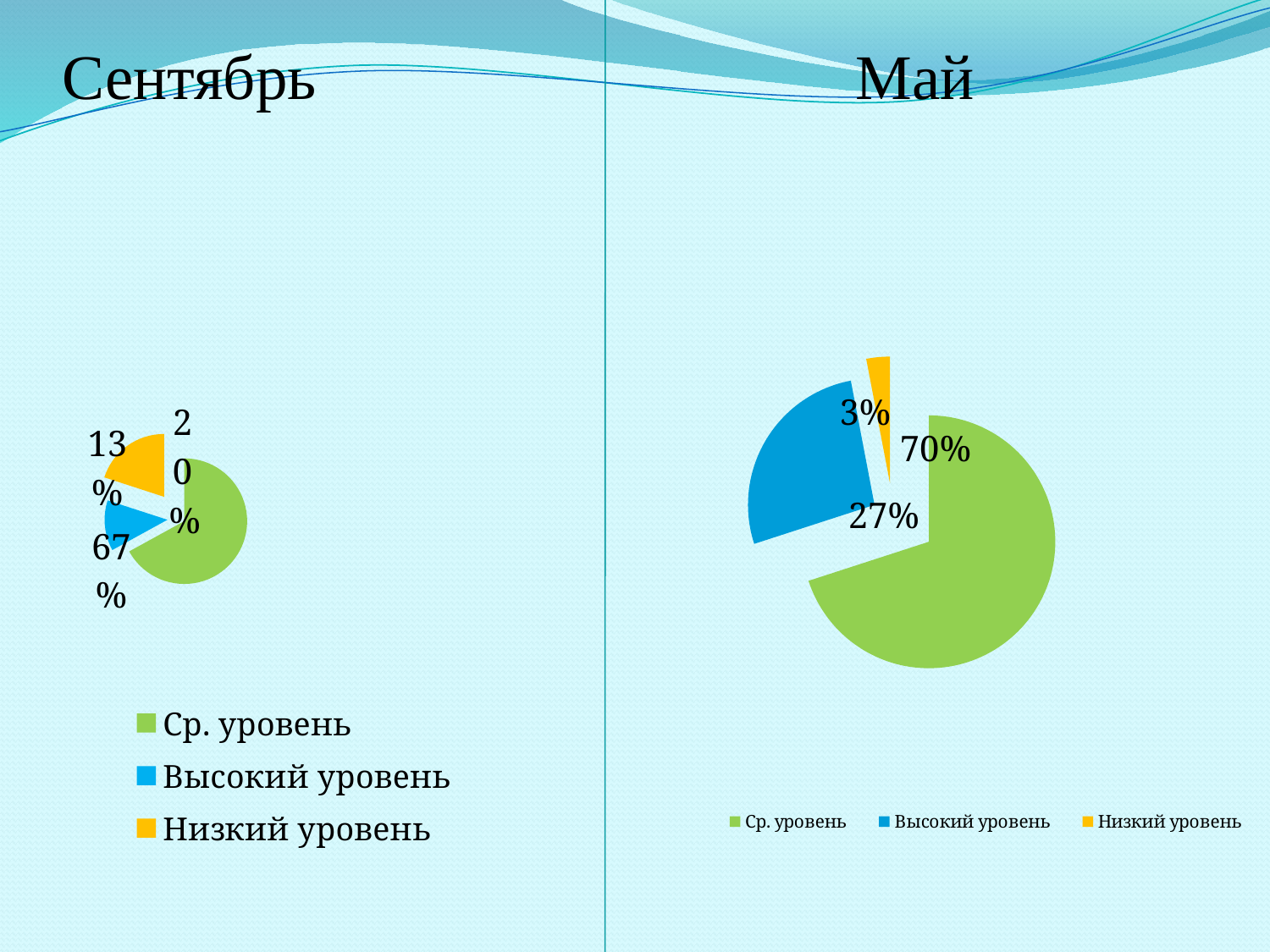
In the "Май" chart, which category has the largest slice? Ср. уровень In the "Сентябрь" chart, which category has the largest slice? Ср. уровень What kind of chart is shown under the title "Май"? pie chart In the "Май" chart, what share does "Высокий уровень" have? 27% In the "Май" chart, what share does "Ср. уровень" have? 70% In the "Май" chart, which category has the smallest slice? Низкий уровень How many categories does the legend of the "Май" chart list? 3 In the "Сентябрь" chart, what share does "Ср. уровень" have? 67% In the "Сентябрь" chart, what colour is the slice for "Низкий уровень"? yellow In the "Май" chart, what is the difference between the shares of "Ср. уровень" and "Высокий уровень"? 43 percentage points Is the share of "Ср. уровень" larger in the "Сентябрь" chart or in the "Май" chart? Май